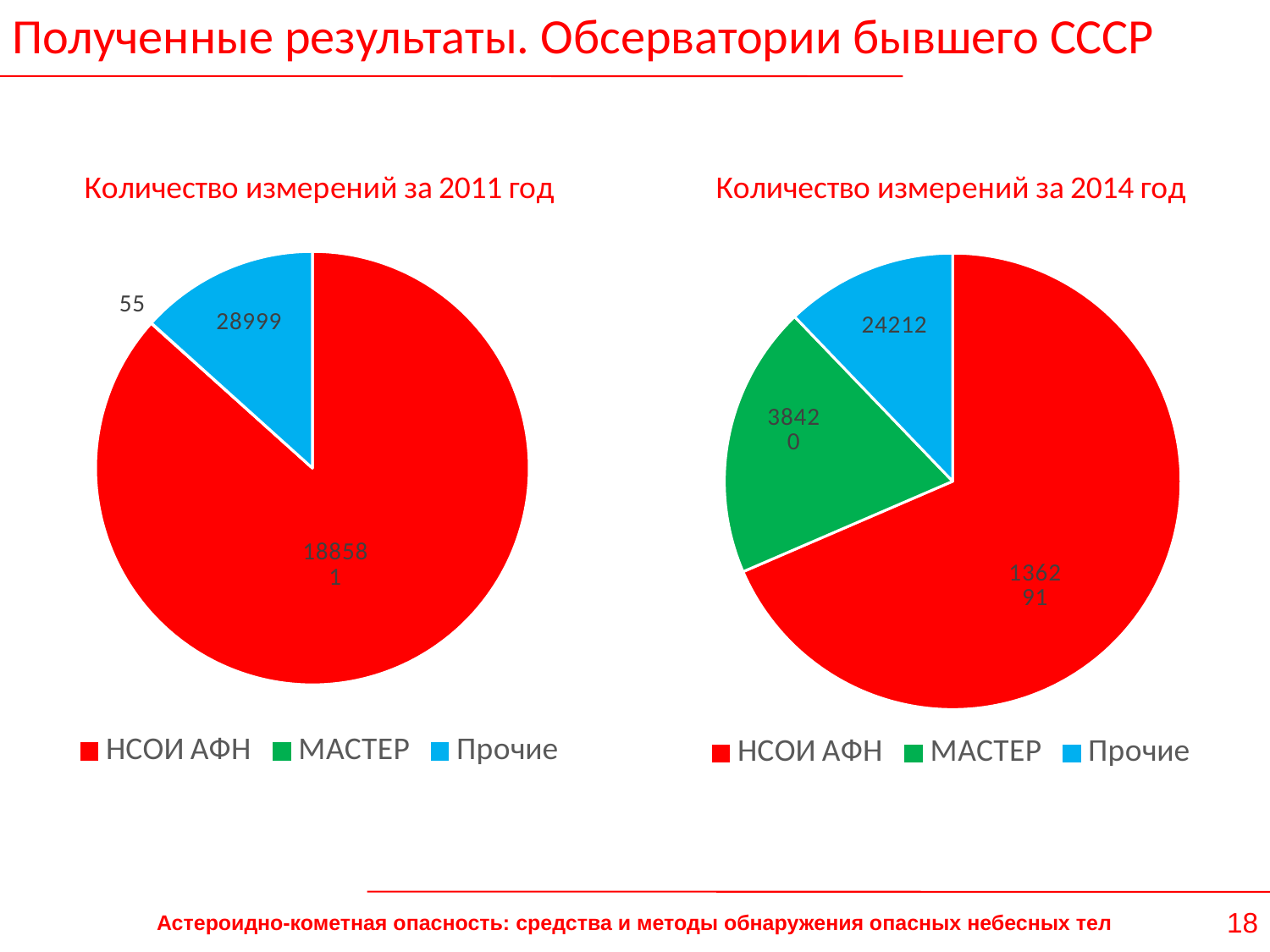
In the chart 'Количество измерений за 2014 год', what is the value for Прочие? 24212 In the chart 'Количество измерений за 2014 год', what is the difference between МАСТЕР and Прочие? 14208 In the chart 'Количество измерений за 2011 год', what is the value for МАСТЕР? 55 In the chart 'Количество измерений за 2014 год', which is larger, МАСТЕР or Прочие? МАСТЕР In the chart 'Количество измерений за 2014 год', what is the value for МАСТЕР? 38420 What kind of charts are shown on the slide? Pie charts In the chart 'Количество измерений за 2011 год', what is the value for Прочие? 28999 In the chart 'Количество измерений за 2011 год', which category has the largest value? НСОИ АФН In the chart 'Количество измерений за 2014 год', what is the value for НСОИ АФН? 136291 How many entries does the legend of the chart 'Количество измерений за 2011 год' list? 3 In the chart 'Количество измерений за 2011 год', which category has the smallest value? МАСТЕР In the chart 'Количество измерений за 2014 год', which category has the smallest value? Прочие